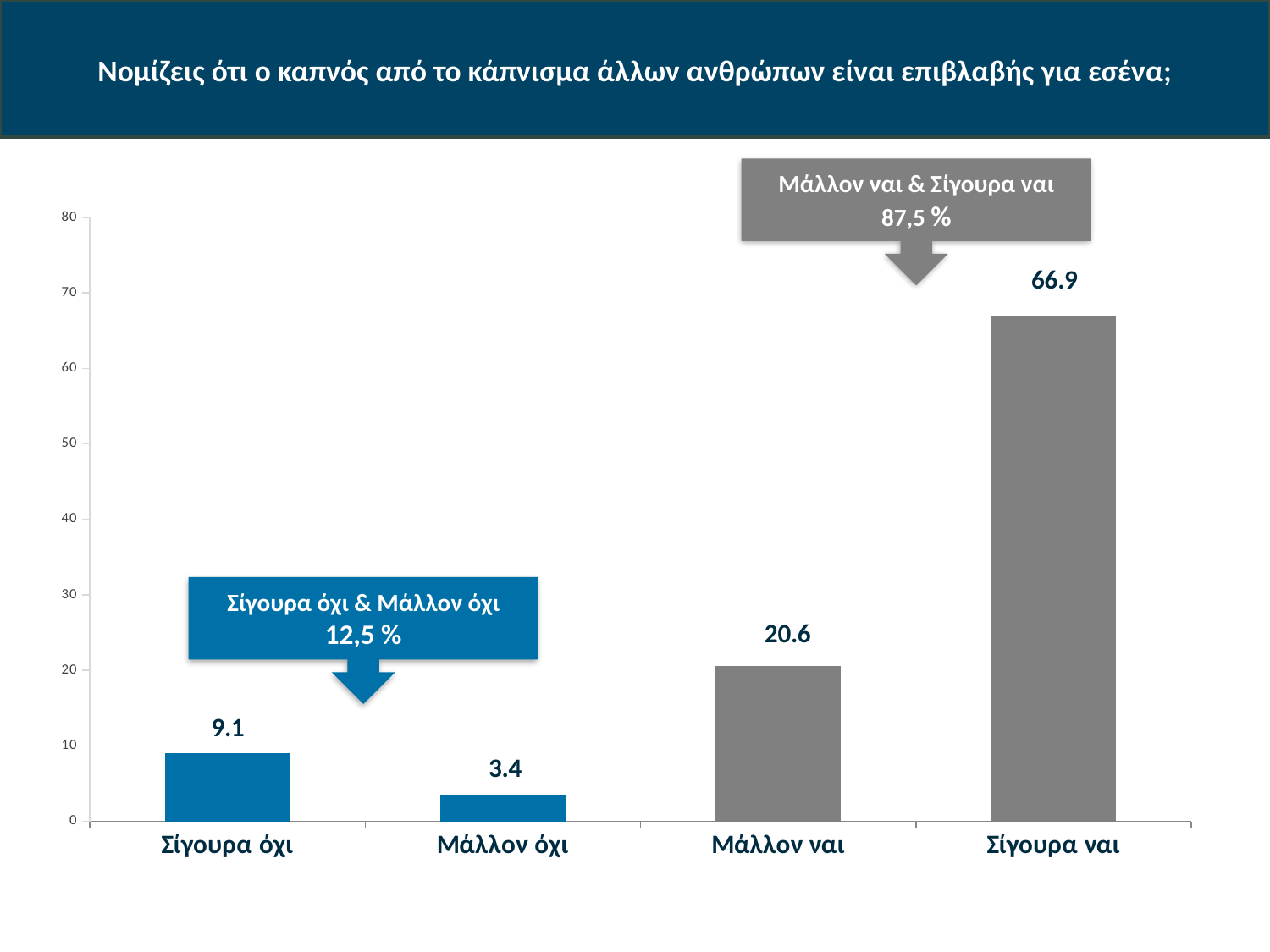
Which is larger, the value for Σίγουρα όχι or the value for Μάλλον όχι? Σίγουρα όχι Which category has the highest value? Σίγουρα ναι How many categories are shown on the x axis? 4 What is the value for Μάλλον όχι? 3.4 Which category has the lowest value? Μάλλον όχι What kind of chart is shown on the slide? bar chart What is the value for Μάλλον ναι? 20.6 Is the value for Μάλλον ναι greater or less than 30? less What is the difference between the values for Σίγουρα ναι and Μάλλον ναι? 46.3 What is the value for Σίγουρα όχι? 9.1 What combined percentage does the grey callout give for Μάλλον ναι & Σίγουρα ναι? 87,5 % What is the value for Σίγουρα ναι? 66.9